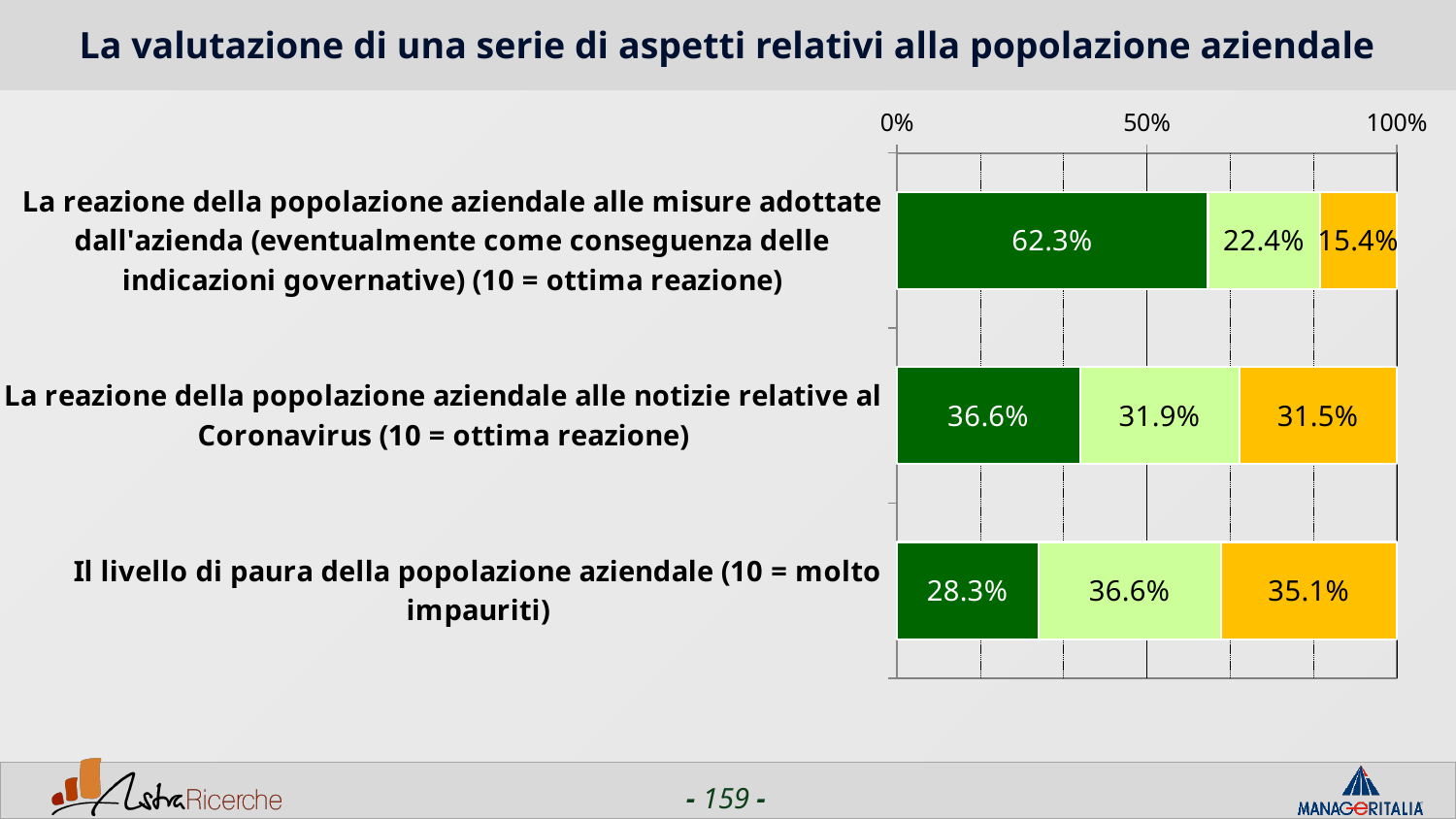
What is the difference between the dark green segments for 'misure adottate dall'azienda' (62.3%) and 'notizie relative al Coronavirus' (36.6%)? 25.7 percentage points What is the total of the three segments for 'La reazione della popolazione aziendale alle notizie relative al Coronavirus'? 100.0% Which category has the smallest dark green segment? Il livello di paura della popolazione aziendale How many categories (rows) are plotted in the chart? 3 What kind of chart is shown on the slide? Stacked bar chart Which category has the largest dark green segment? La reazione della popolazione aziendale alle misure adottate dall'azienda What is the value of the orange segment for 'Il livello di paura della popolazione aziendale'? 35.1% Is the dark green segment for 'La reazione della popolazione aziendale alle misure adottate dall'azienda' greater or less than 50%? greater What is the value of the dark green segment for 'La reazione della popolazione aziendale alle misure adottate dall'azienda'? 62.3% What is the value of the light green segment for 'La reazione della popolazione aziendale alle notizie relative al Coronavirus'? 31.9% Which is larger: the orange segment for 'notizie relative al Coronavirus' or the orange segment for 'Il livello di paura della popolazione aziendale'? Il livello di paura della popolazione aziendale What is the maximum value shown on the horizontal axis? 100%